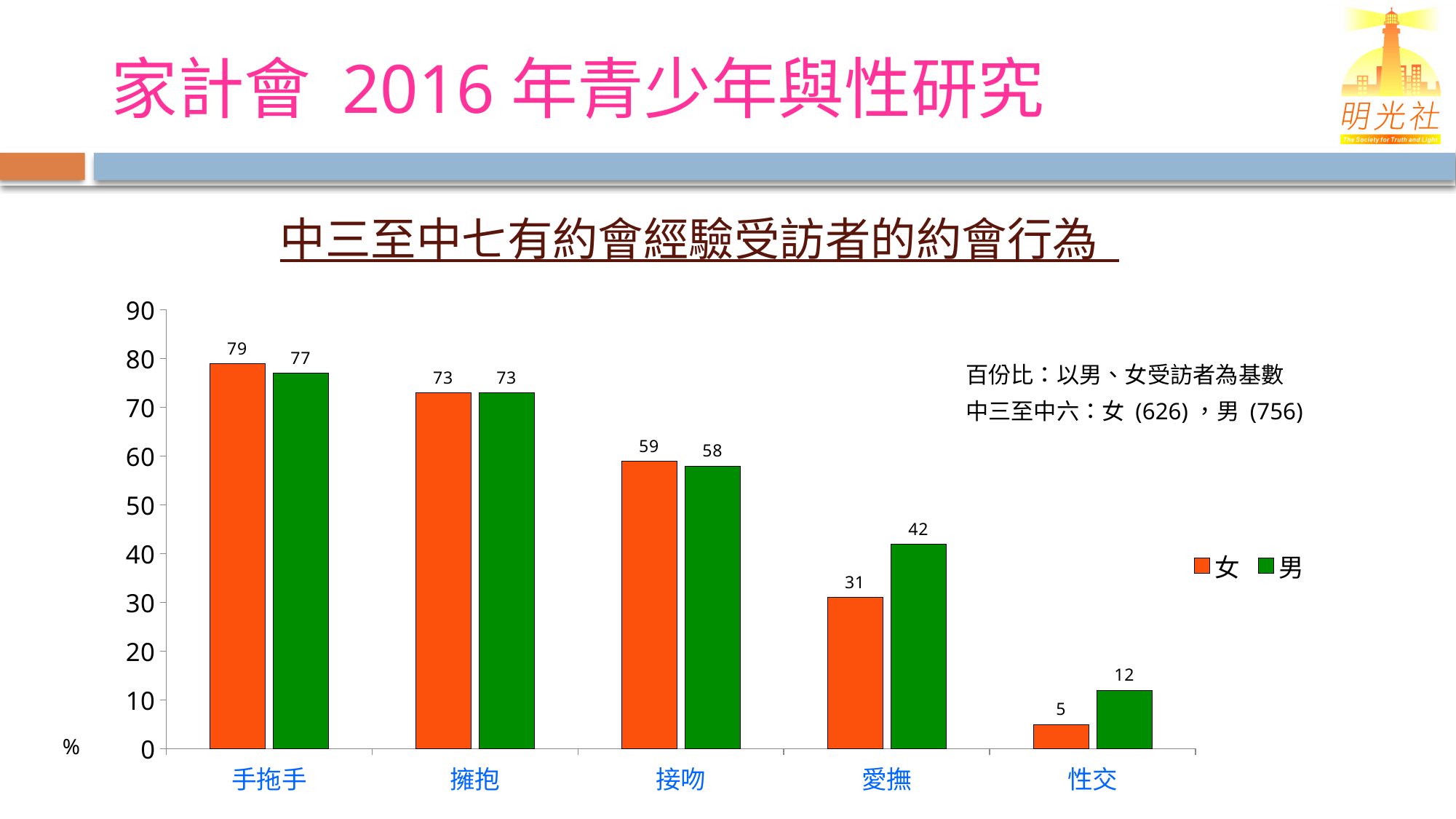
What is the value for 男 (male) in the 愛撫 category? 42 How many series does the legend list? 2 What is the value for 女 (female) in the 性交 category? 5 In the 手拖手 category, which series has the larger value, 女 or 男? 女 Which category has the highest value for the 男 (male) series? 手拖手 In the 性交 category, which series has the larger value, 女 or 男? 男 What is the difference between the 男 and 女 values in the 愛撫 category? 11 Which category has the lowest value for the 女 (female) series? 性交 What is the value for 女 (female) in the 手拖手 category? 79 Do the values for the 女 series rise or fall from 手拖手 to 性交 along the x axis? Fall How many categories are shown on the x axis of the chart? 5 What kind of chart is shown on the slide? Bar chart